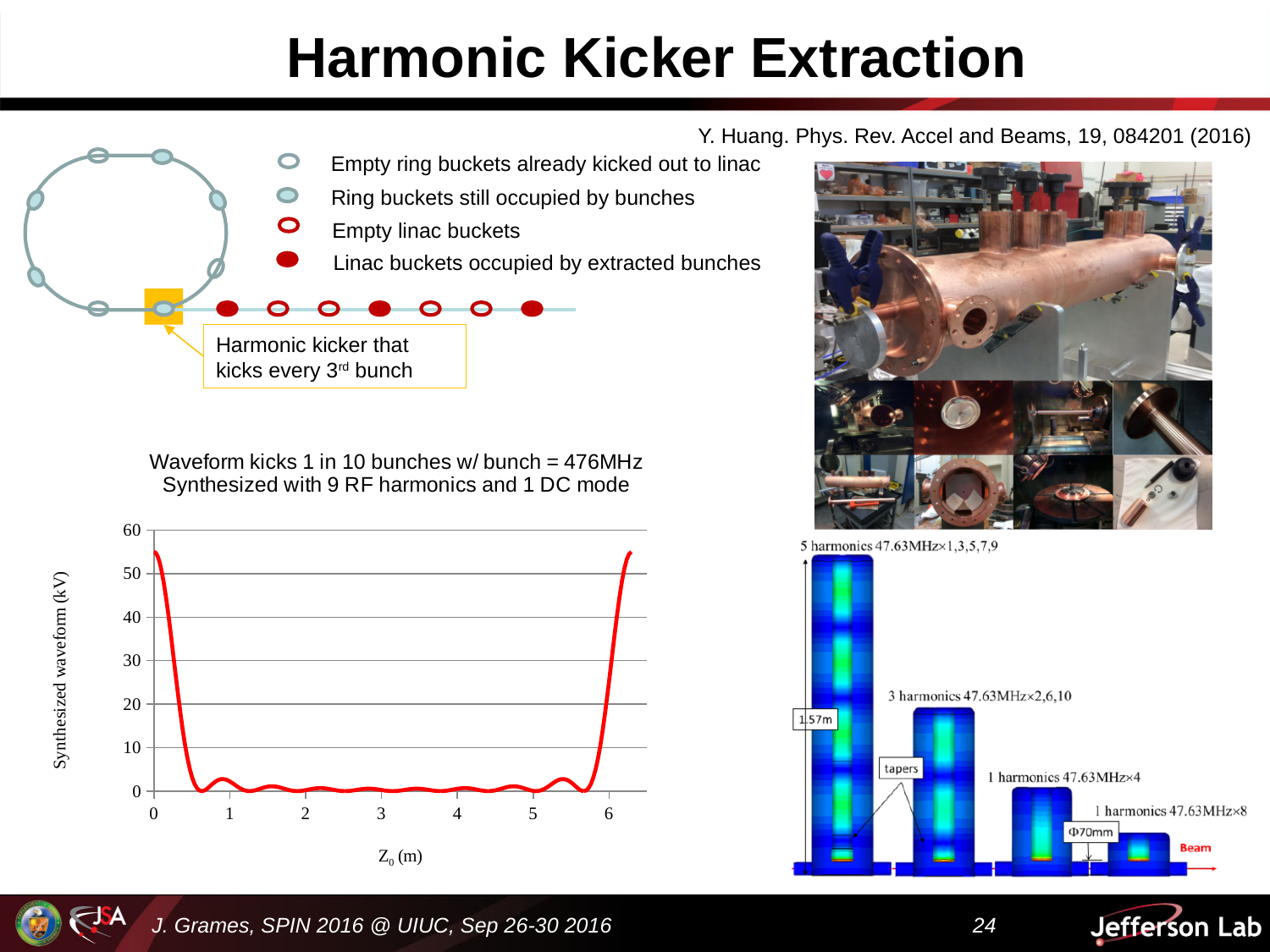
Is the synthesized waveform value at Z0 = 0 m greater or less than 50 kV? greater Is the synthesized waveform value at Z0 = 1 m greater or less than 10 kV? less Does the synthesized waveform rise or fall as Z0 goes from 5.5 m to 6.3 m? rise What kind of chart is shown at the bottom left of the slide? line chart What is the label of the y axis of the waveform chart? Synthesized waveform (kV) Which has the larger synthesized waveform value, Z0 = 0 m or Z0 = 3 m? Z0 = 0 m Does the synthesized waveform rise or fall as Z0 goes from 0 m to 1 m? fall Is the synthesized waveform value at Z0 = 3 m greater or less than 10 kV? less What is the label of the x axis of the waveform chart? Z0 (m)